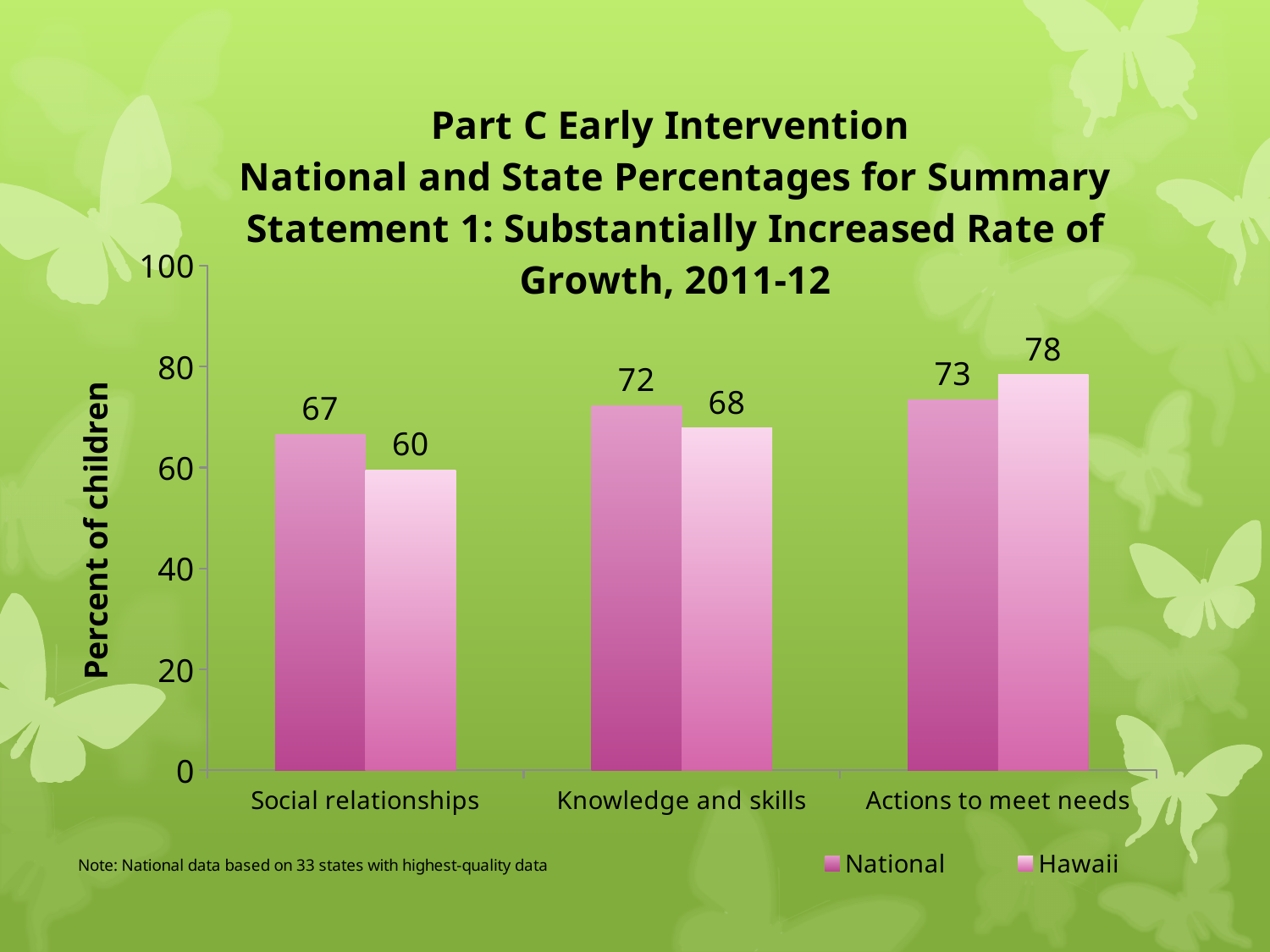
What is the label of the y axis? Percent of children How many categories are shown on the x axis? 3 How many series does the legend list? 2 Which category has the highest Hawaii value? Actions to meet needs What is the National value for Social relationships? 67 What is the difference between the National and Hawaii values for Social relationships? 7 What kind of chart is shown on the slide? bar chart Which is larger for Knowledge and skills, the National value or the Hawaii value? National Which category has the lowest National value? Social relationships Is the Hawaii value for Social relationships greater or less than 80? less What is the Hawaii value for Actions to meet needs? 78 What is the Hawaii value for Knowledge and skills? 68